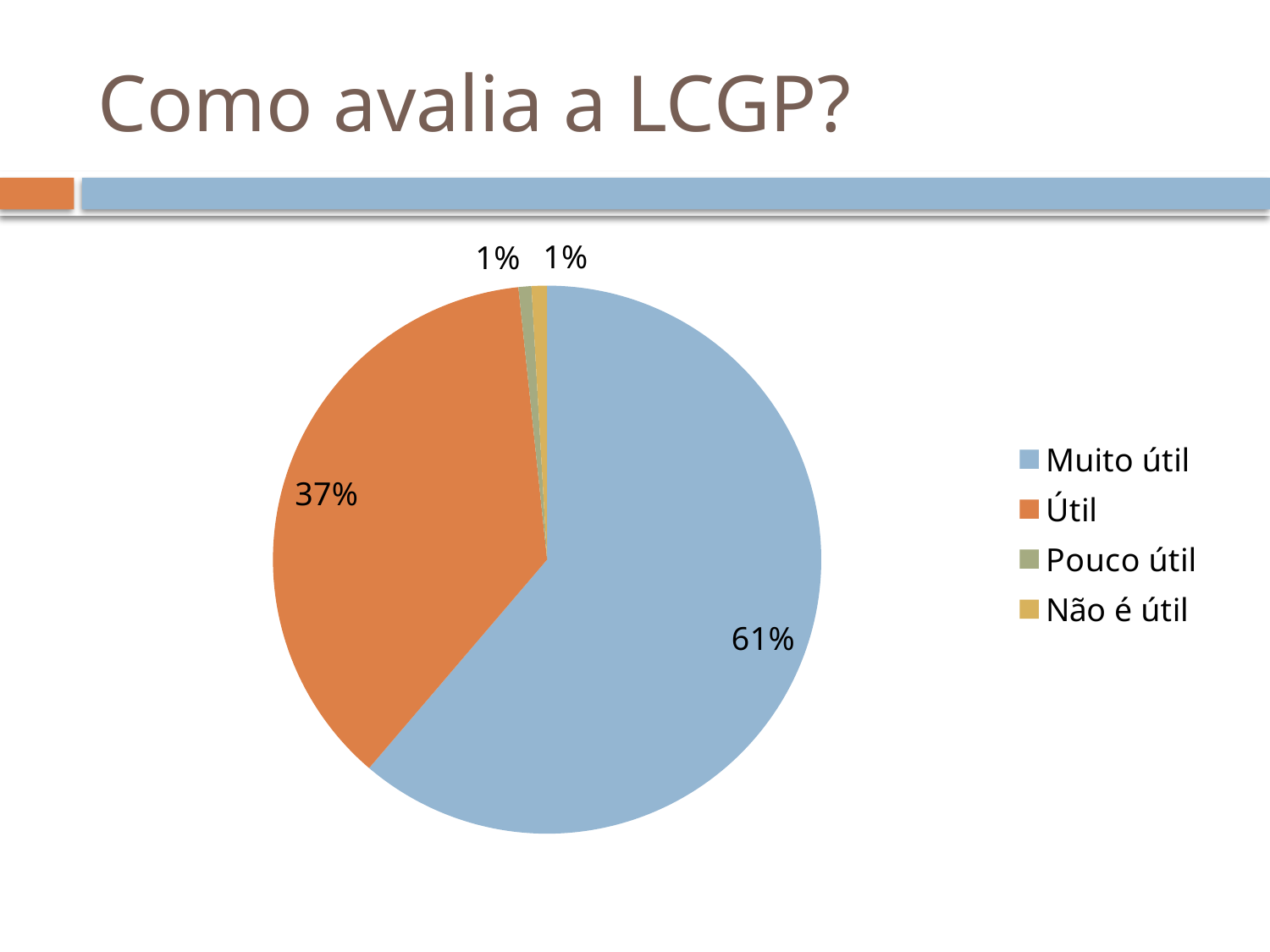
What is the combined share of "Muito útil" and "Útil"? 98% What share of the pie does "Não é útil" represent? 1% How many categories does the pie chart show? 4 What is the difference in percentage points between "Muito útil" and "Útil"? 24 What share of the pie does "Muito útil" represent? 61% What kind of chart is shown on the slide? Pie chart Which category is shown in orange in the legend? Útil What share of the pie does "Útil" represent? 37% Which category has the largest slice of the pie? Muito útil What is the title of the slide containing the chart? Como avalia a LCGP? Which is larger, the share for "Útil" or the share for "Muito útil"? Muito útil